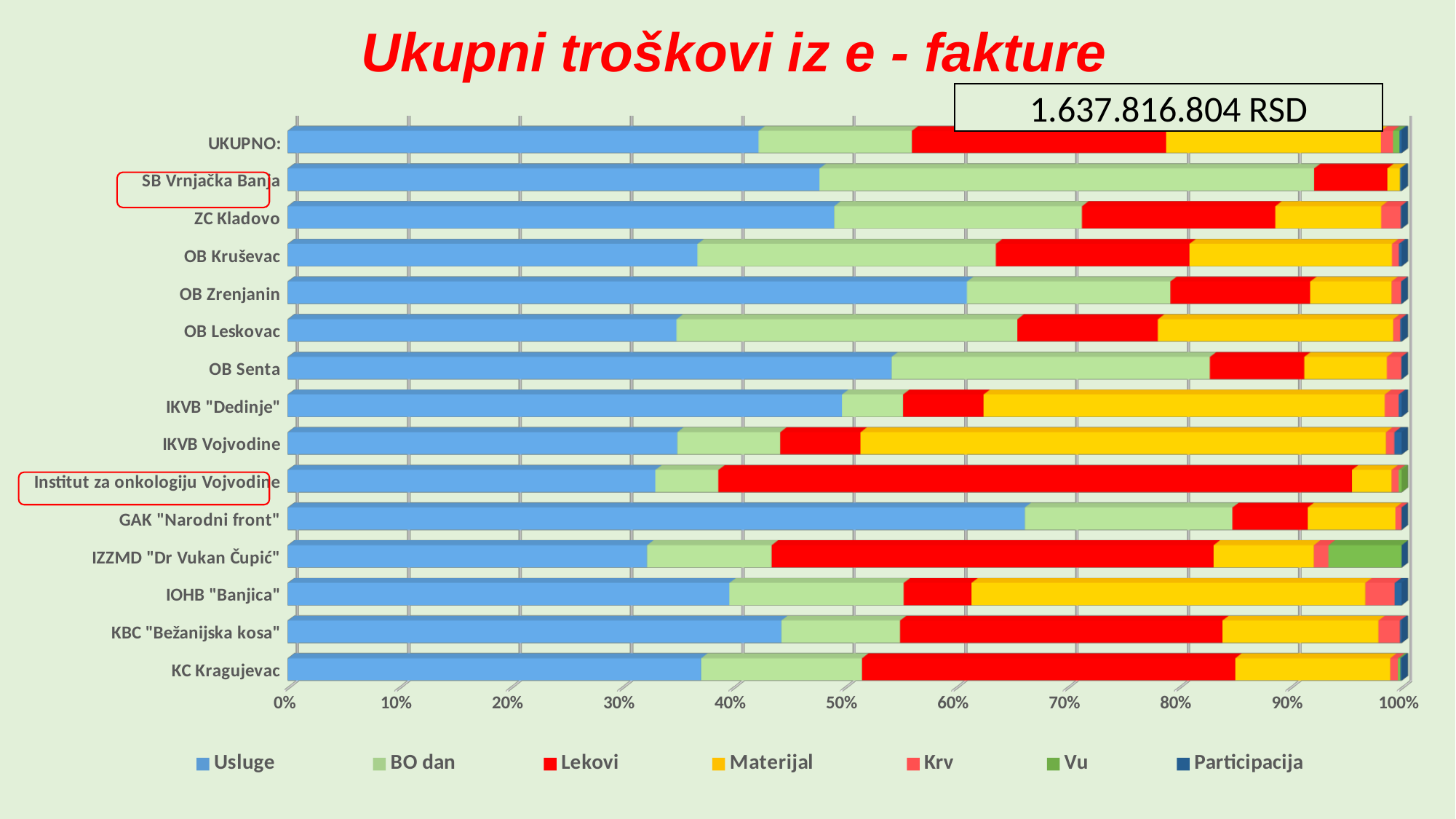
What is the title of the chart? Ukupni troškovi iz e - fakture What total amount in RSD is shown in the box on the slide? 1.637.816.804 RSD Which category has the largest Materijal share? IKVB Vojvodine How many series does the legend list? 7 Which has a larger Usluge share, OB Senta or OB Kruševac? OB Senta Which category has the largest Lekovi share? Institut za onkologiju Vojvodine How many categories (rows) are plotted on the chart? 15 Which category has the largest Usluge share? GAK "Narodni front" Is the Usluge share for GAK "Narodni front" greater or less than 60%? greater Is the Usluge share for OB Leskovac greater or less than 40%? less What kind of chart is shown on the slide? Stacked bar chart